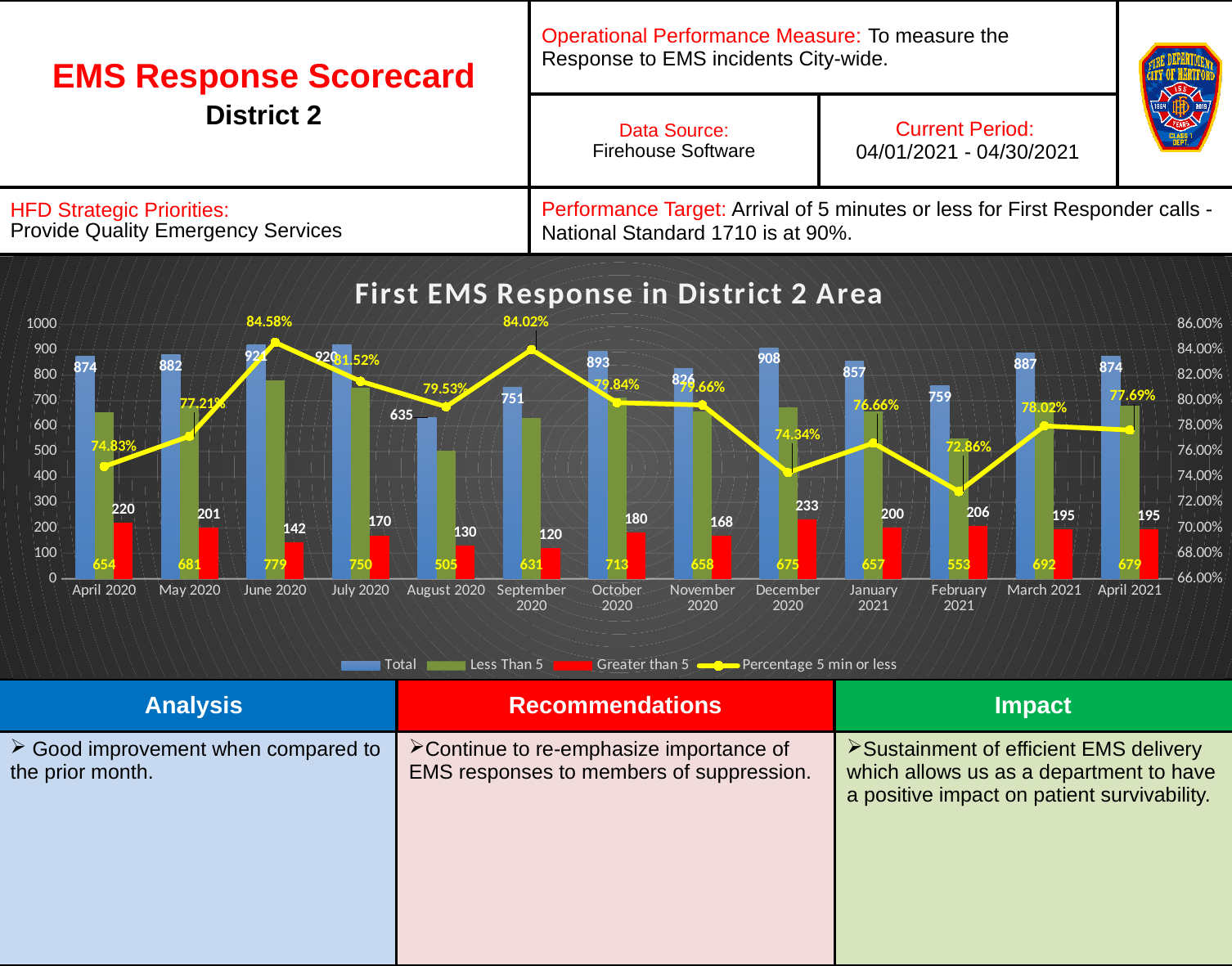
Which month has the lowest Total value? August 2020 What is the Less Than 5 value for July 2020? 750 What is the difference between the Total values for March 2021 and April 2021? 13 What is the Total value for December 2020? 908 What is the Percentage 5 min or less for February 2021? 72.86% Which month has the highest Greater than 5 value? December 2020 What is the title of the chart on the slide? First EMS Response in District 2 Area Which month has the highest Total value? June 2020 Which month has the highest Percentage 5 min or less? June 2020 How many series does the chart legend list? 4 Which is larger, the Greater than 5 value for April 2020 or for May 2020? April 2020 How many months are shown on the x axis of the chart? 13